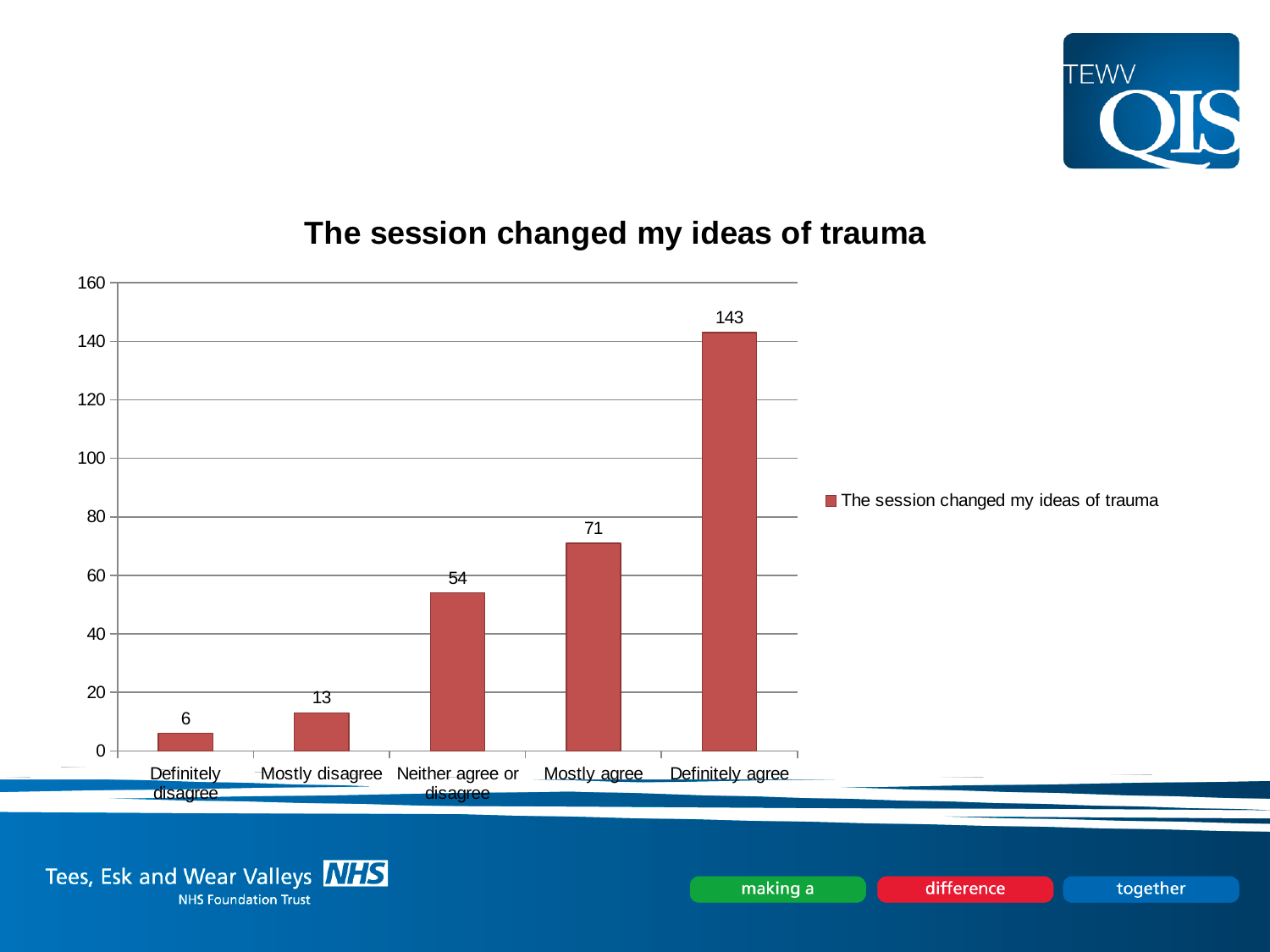
What is the value for "Mostly disagree"? 13 How many series does the legend list? 1 What kind of chart is shown? bar chart Which category has the highest value? Definitely agree What is the title of the chart? The session changed my ideas of trauma What is the difference between the values for "Definitely agree" and "Mostly agree"? 72 Which category has the lowest value? Definitely disagree Is the value for "Definitely agree" greater or less than 140? greater What is the value for "Neither agree or disagree"? 54 How many categories are shown on the x axis? 5 What is the value for "Definitely agree"? 143 Which is larger, the value for "Mostly agree" or the value for "Neither agree or disagree"? Mostly agree